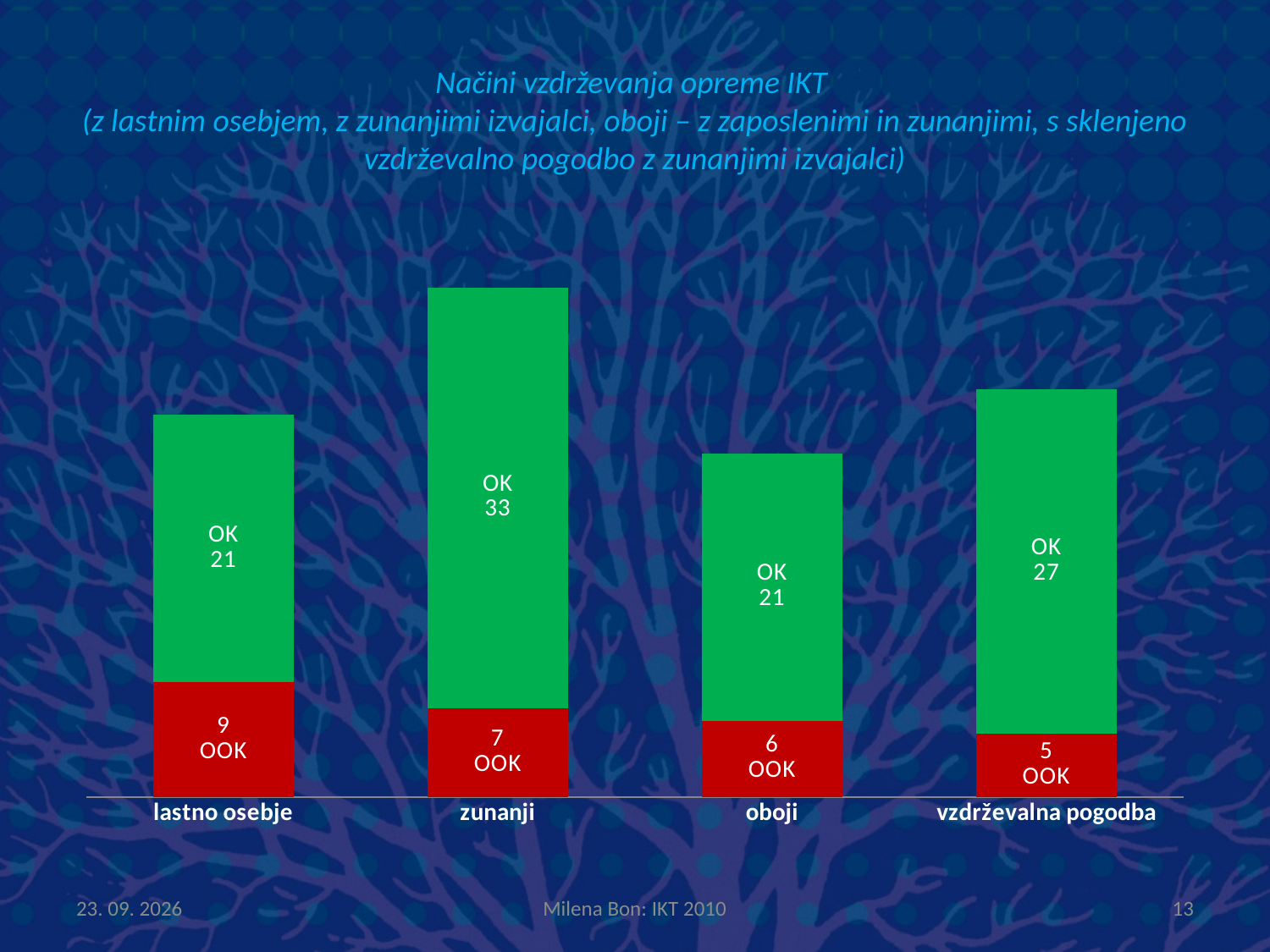
How many categories are shown on the x axis? 4 What is the OK value for vzdrževalna pogodba? 27 What is the total of the stacked bar for lastno osebje? 30 What type of chart is shown on the slide? stacked bar chart Which category has the lowest OOK value? vzdrževalna pogodba What is the OOK value for lastno osebje? 9 What is the difference between the OK values for zunanji and oboji? 12 What is the total of the stacked bar for zunanji? 40 What is the OOK value for oboji? 6 Which category has the highest OK value? zunanji What is the OK value for zunanji? 33 Which is larger, the OOK value for lastno osebje or the OOK value for zunanji? lastno osebje